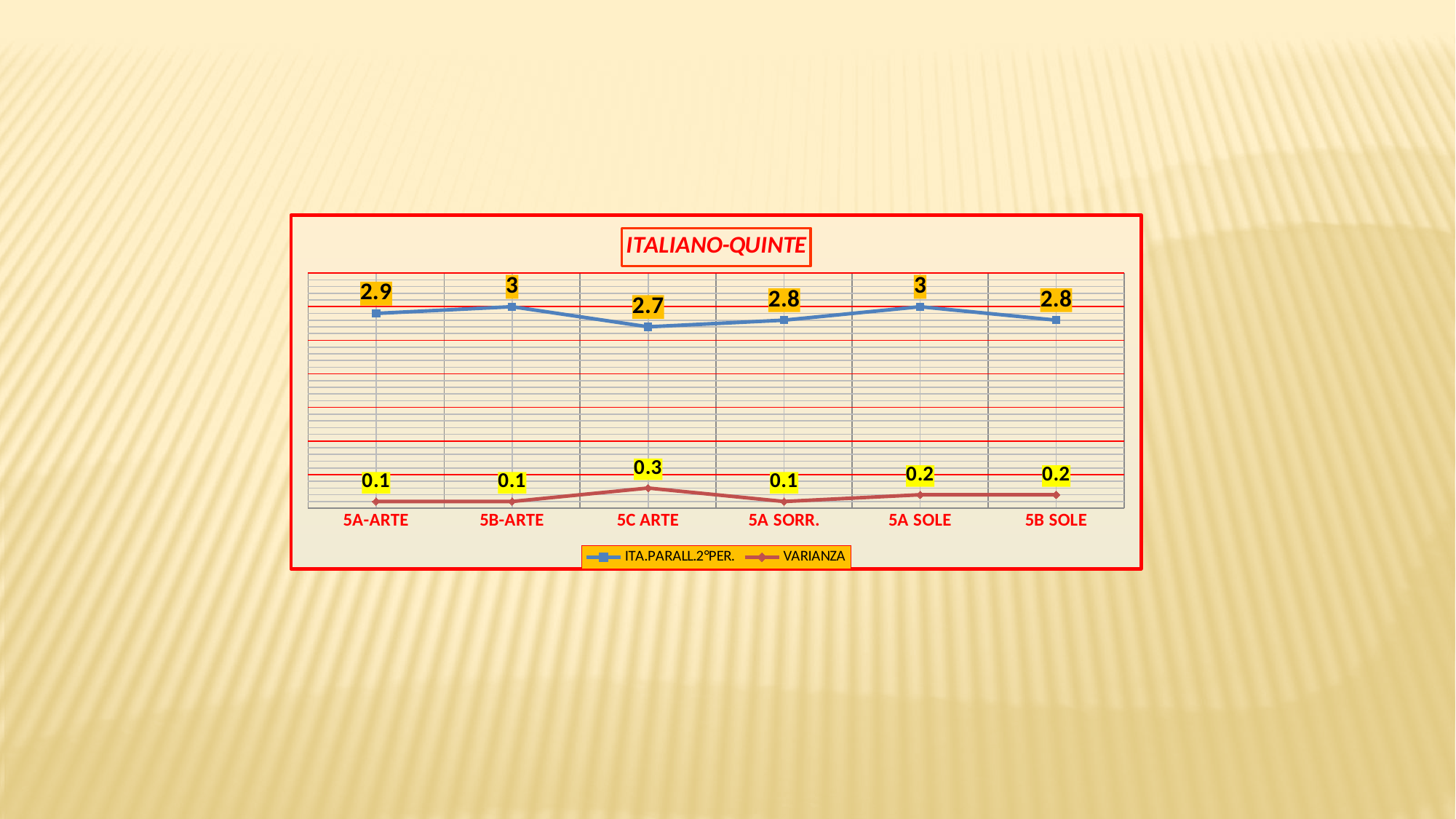
What is the ITA.PARALL.2°PER. value for 5A-ARTE? 2.9 What is the difference between the VARIANZA values for 5C ARTE and 5A SORR.? 0.2 Which is larger, the ITA.PARALL.2°PER. value for 5A-ARTE or for 5A SORR.? 5A-ARTE What is the VARIANZA value for 5A SOLE? 0.2 What is the difference between the ITA.PARALL.2°PER. values for 5B-ARTE and 5C ARTE? 0.3 What is the title of the chart? ITALIANO-QUINTE What kind of chart is shown on the slide? line chart Which category has the lowest ITA.PARALL.2°PER. value? 5C ARTE What is the ITA.PARALL.2°PER. value for 5C ARTE? 2.7 How many series does the legend list? 2 How many categories are shown on the x axis? 6 Which category has the highest VARIANZA value? 5C ARTE